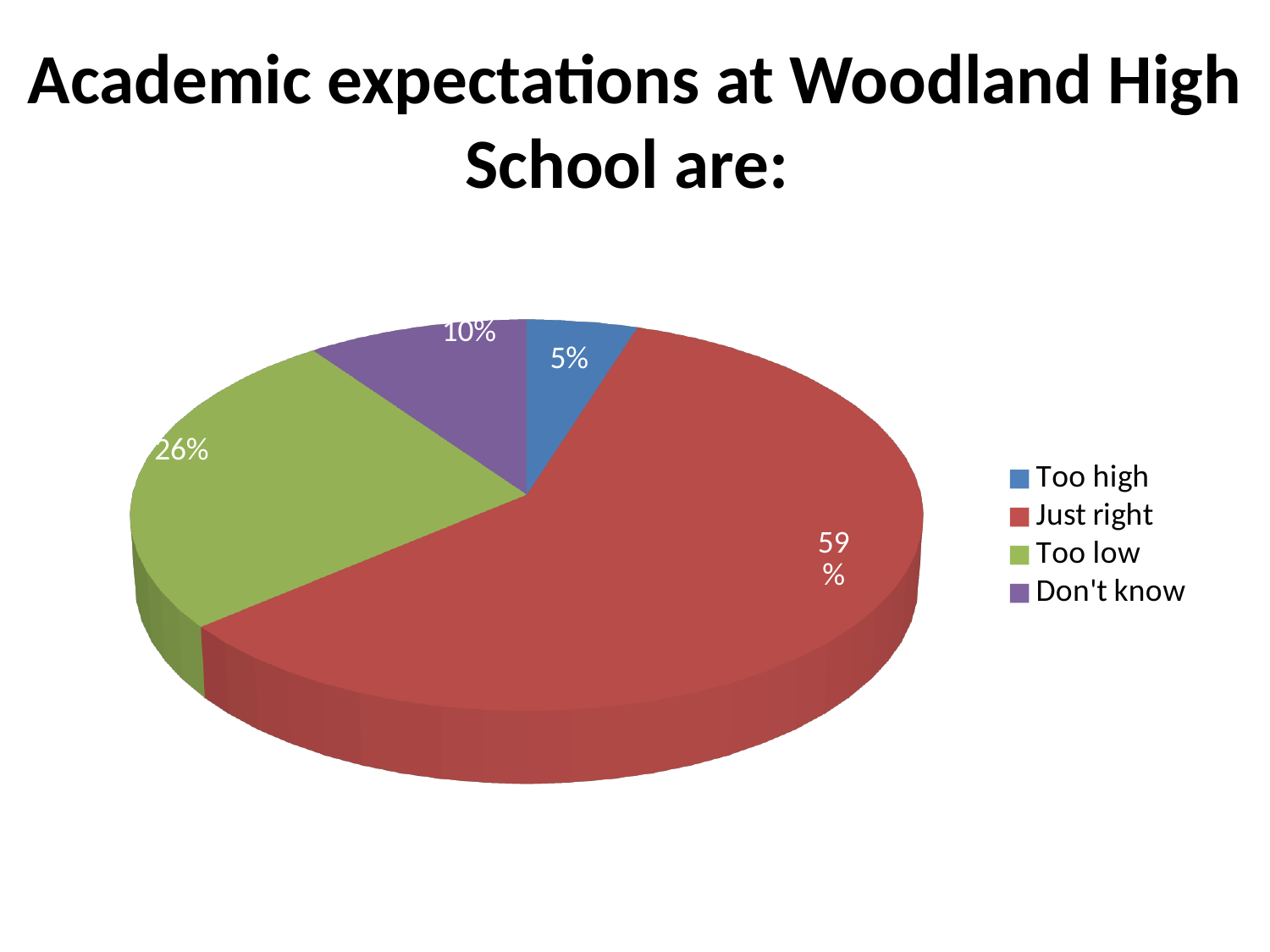
Which category has the smallest slice of the pie? Too high What is the difference in percentage points between "Just right" and "Too low"? 33 What share of the pie is labelled "Too low"? 26% Which category has the largest slice of the pie? Just right What share of the pie is labelled "Too high"? 5% Which is larger, the share for "Too low" or the share for "Don't know"? Too low What kind of chart is shown on the slide? pie chart How many categories does the pie chart show? 4 What is the title of the chart? Academic expectations at Woodland High School are: What share of the pie is labelled "Just right"? 59% What colour is the "Too low" slice? green